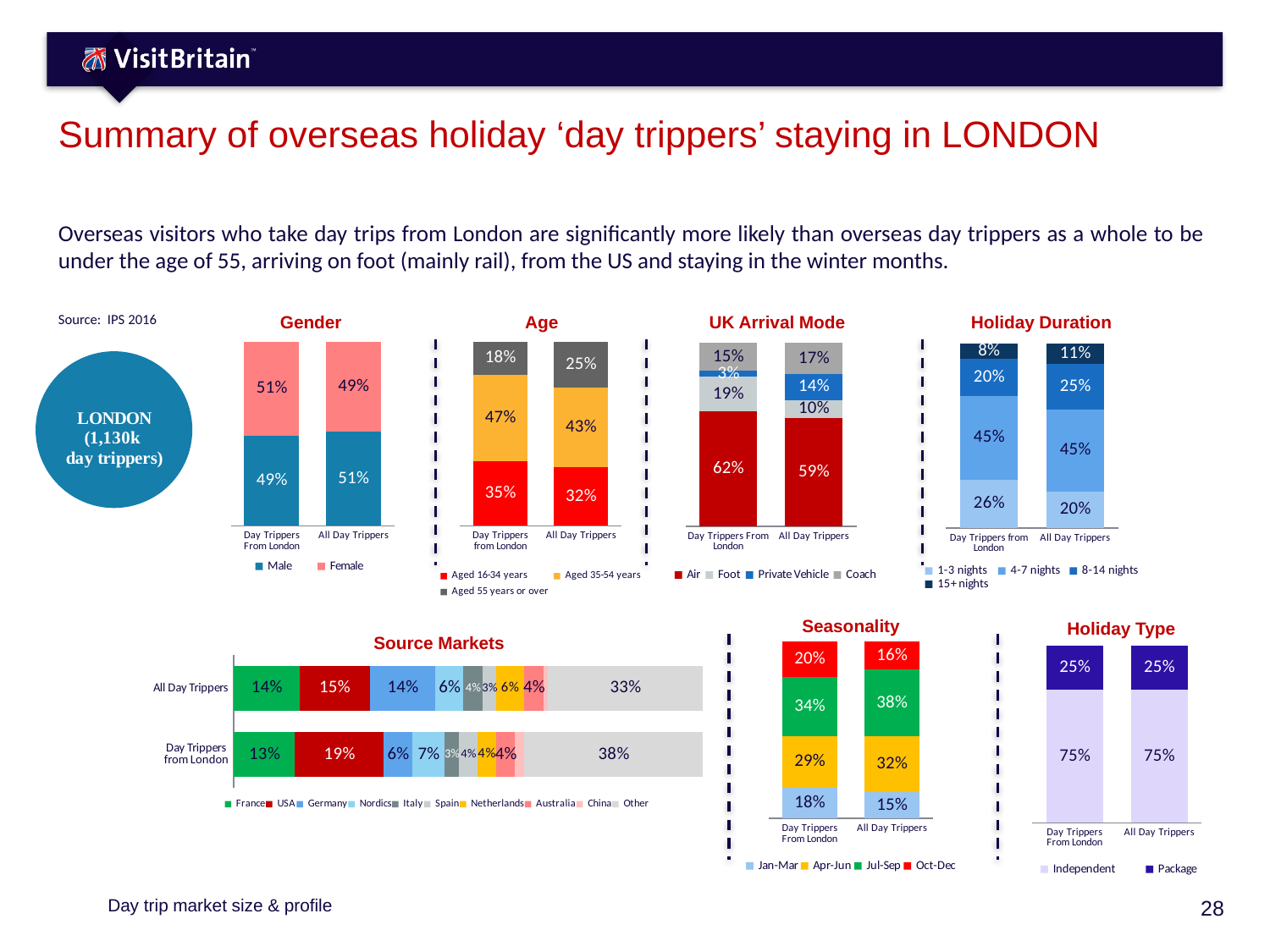
In the Age chart, what is the difference between the Aged 55 years or over share for All Day Trippers and for Day Trippers from London? 7% In the Seasonality chart, what share of All Day Trippers visit in Jul-Sep? 38% In the Source Markets chart, what percentage of Day Trippers from London come from the USA? 19% In the UK Arrival Mode chart, what percentage of Day Trippers From London arrive by Air? 62% In the Holiday Type chart, what percentage of Day Trippers From London are Independent? 75% In the Holiday Duration chart, what percentage of Day Trippers from London stay 1-3 nights? 26% In the Age chart, what share of Day Trippers from London are Aged 35-54 years? 47% In the Seasonality chart, which quarter has the smallest share for Day Trippers From London? Jan-Mar How many series does the legend of the Holiday Duration chart list? 4 In the UK Arrival Mode chart, which arrival mode is the largest for All Day Trippers? Air In the Gender chart, what percentage of Day Trippers From London are Male? 49% In the UK Arrival Mode chart, is the Foot share larger for Day Trippers From London or for All Day Trippers? Day Trippers From London